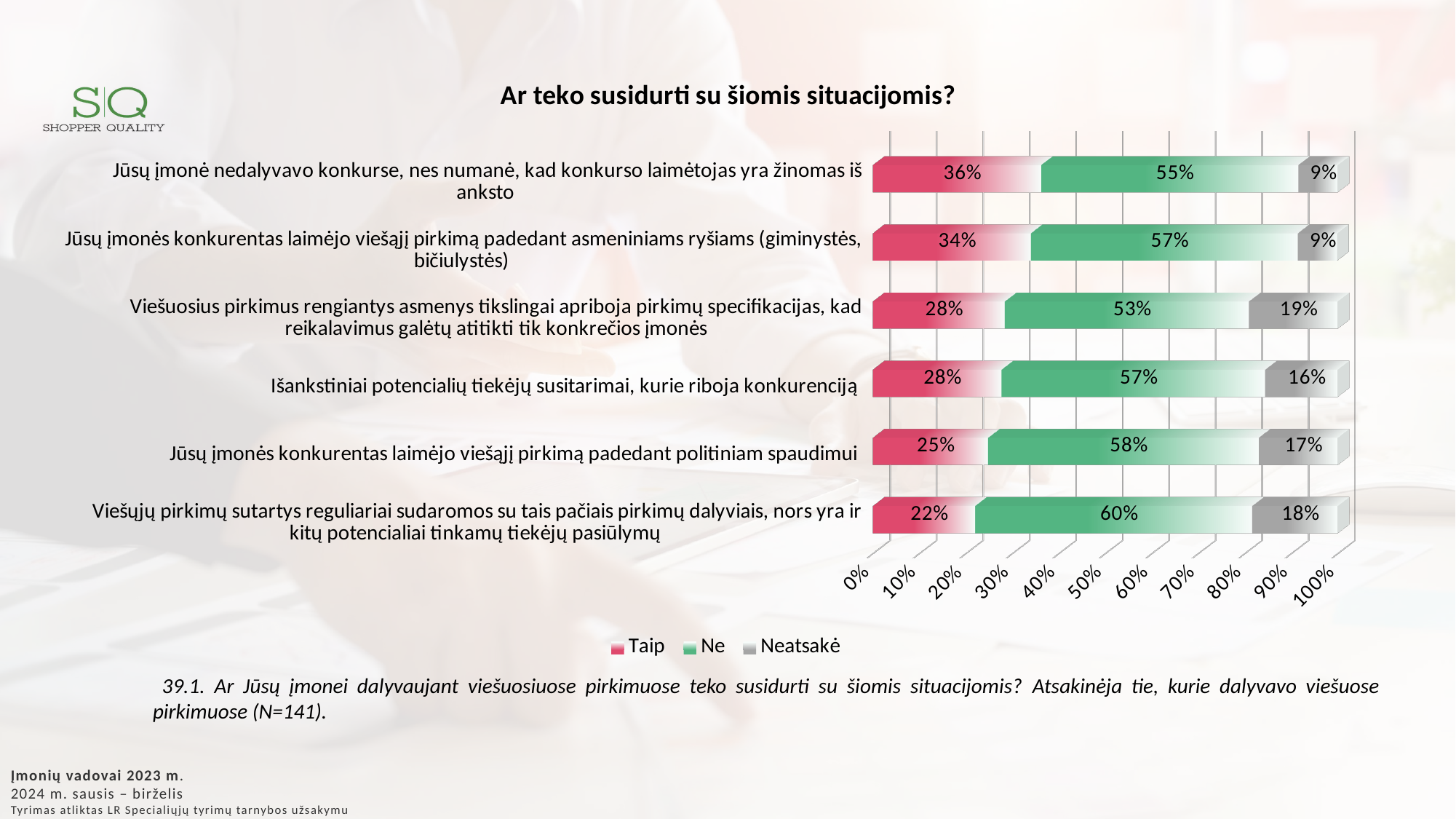
What is the difference between the 'Ne' value for 'Viešųjų pirkimų sutartys reguliariai sudaromos su tais pačiais pirkimų dalyviais...' and the 'Ne' value for 'Viešuosius pirkimus rengiantys asmenys tikslingai apriboja pirkimų specifikacijas...'? 7% Which statement has the lowest 'Taip' value? Viešųjų pirkimų sutartys reguliariai sudaromos su tais pačiais pirkimų dalyviais, nors yra ir kitų potencialiai tinkamų tiekėjų pasiūlymų What is the total of the stacked bar for 'Jūsų įmonės konkurentas laimėjo viešąjį pirkimą padedant politiniam spaudimui'? 100% How many categories (statements) are plotted in the chart? 6 What kind of chart is shown on the slide? Stacked bar chart What is the 'Neatsakė' value for 'Viešuosius pirkimus rengiantys asmenys tikslingai apriboja pirkimų specifikacijas, kad reikalavimus galėtų atitikti tik konkrečios įmonės'? 19% What is the title of the chart? Ar teko susidurti su šiomis situacijomis? Which is larger: the 'Taip' value for 'Jūsų įmonės konkurentas laimėjo viešąjį pirkimą padedant asmeniniams ryšiams' or the 'Taip' value for 'Jūsų įmonės konkurentas laimėjo viešąjį pirkimą padedant politiniam spaudimui'? Jūsų įmonės konkurentas laimėjo viešąjį pirkimą padedant asmeniniams ryšiams What is the 'Ne' value for 'Išankstiniai potencialių tiekėjų susitarimai, kurie riboja konkurenciją'? 57% How many series does the legend list? 3 Which statement has the highest 'Taip' value? Jūsų įmonė nedalyvavo konkurse, nes numanė, kad konkurso laimėtojas yra žinomas iš anksto What is the 'Taip' value for 'Jūsų įmonė nedalyvavo konkurse, nes numanė, kad konkurso laimėtojas yra žinomas iš anksto'? 36%